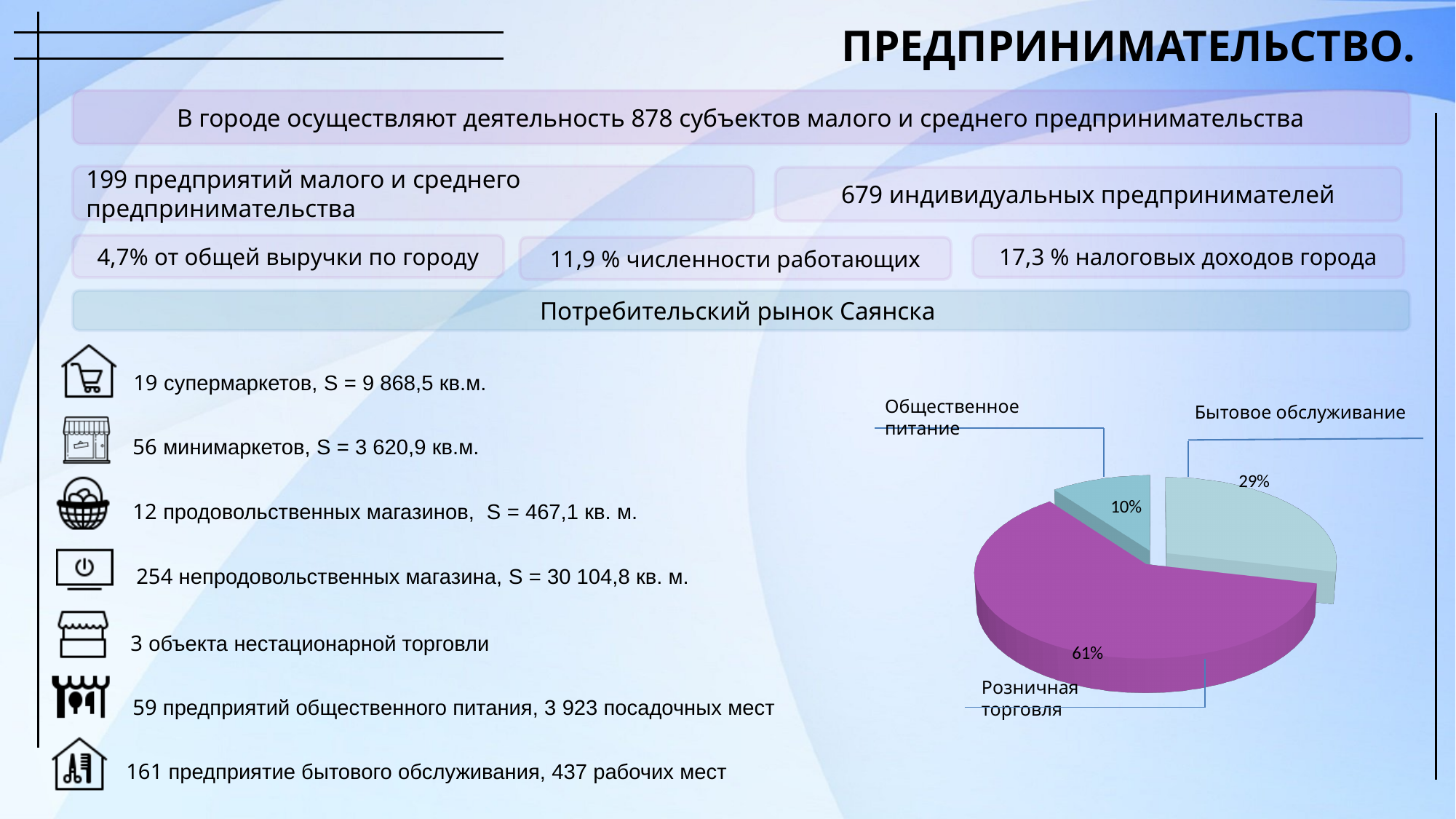
What colour is the Розничная торговля slice in the pie chart? magenta (purple-pink) How many slices does the pie chart have? 3 What share of the pie does Общественное питание have? 10% Is the share for Розничная торговля greater or less than 50%? greater What is the difference in percentage points between Бытовое обслуживание and Общественное питание? 19 Which is larger in the pie chart, Бытовое обслуживание or Общественное питание? Бытовое обслуживание Which slice of the pie chart is the largest? Розничная торговля What kind of chart is shown on the slide? pie chart What share of the pie does Розничная торговля have? 61% What is the difference in percentage points between Розничная торговля and Бытовое обслуживание? 32 Which slice of the pie chart is the smallest? Общественное питание What share of the pie does Бытовое обслуживание have? 29%